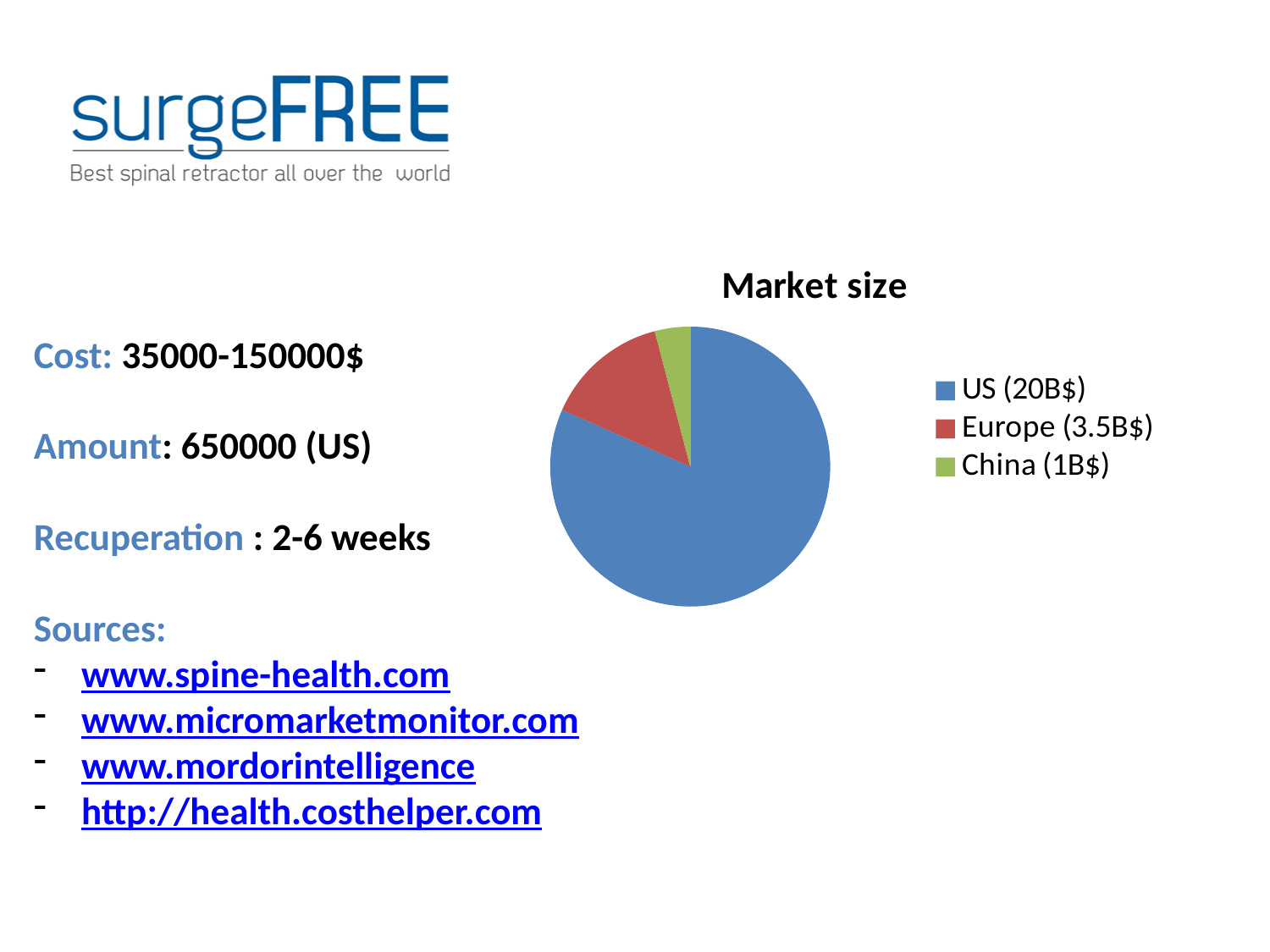
How many entries does the chart legend list? 3 What is the market size for the US according to the legend? 20B$ Which region has the smallest slice of the pie? China How many slices does the pie chart have? 3 What is the difference between the US market size and the Europe market size? 16.5B$ What is the market size for Europe according to the legend? 3.5B$ What kind of chart is shown on the slide? pie chart Which colour represents Europe in the pie chart? red Which is larger, the market size for Europe or for China? Europe What is the market size for China according to the legend? 1B$ Which region has the largest slice of the pie? US What is the title of the chart? Market size